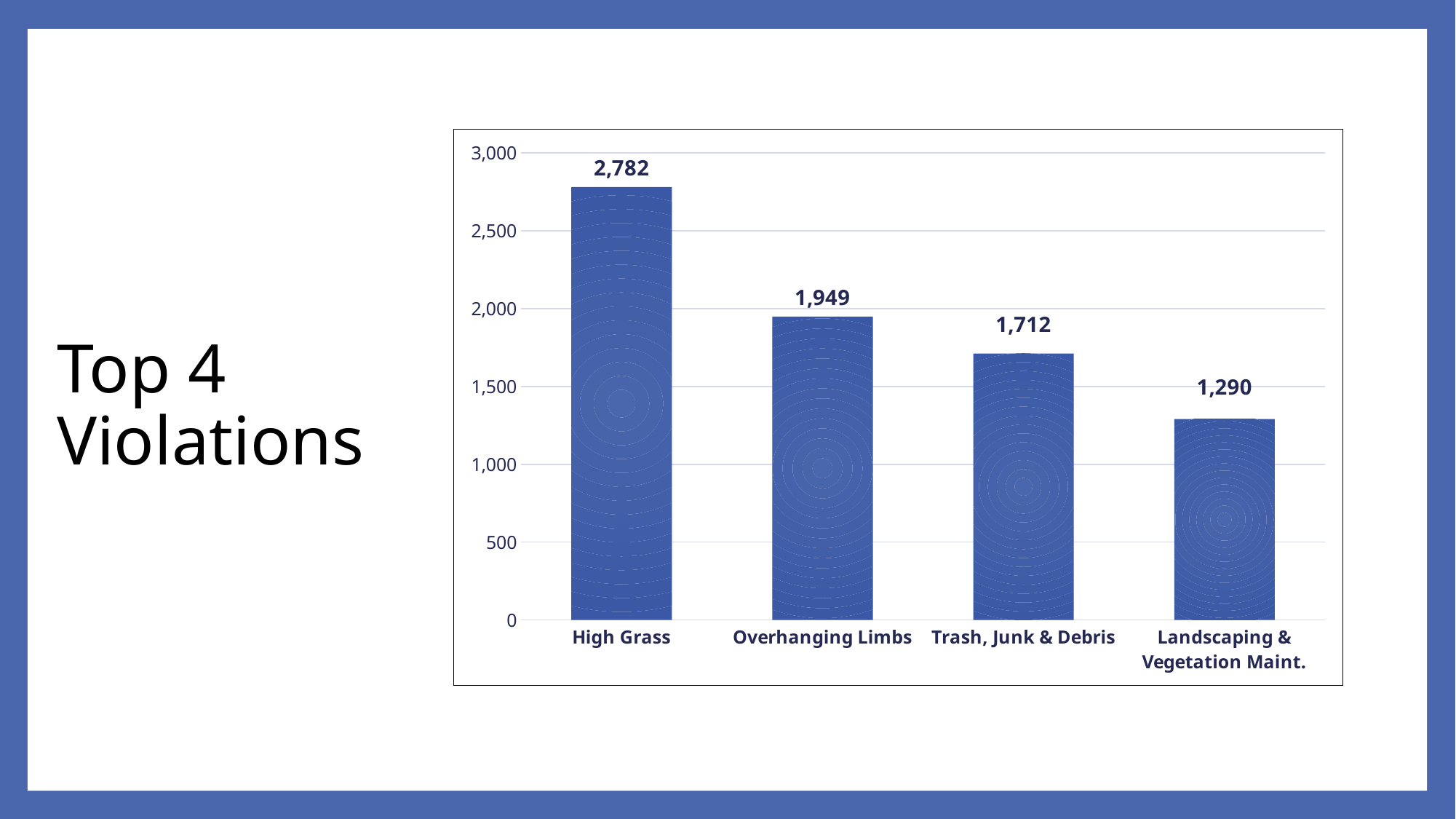
Which category has the lowest value? Landscaping & Vegetation Maint. Do the values rise or fall from left to right across the categories? Fall Which is larger, the value for Overhanging Limbs or the value for Trash, Junk & Debris? Overhanging Limbs What is the value for Overhanging Limbs? 1,949 What kind of chart is shown on the slide? Bar chart What is the value for Trash, Junk & Debris? 1,712 What is the difference between the values for Trash, Junk & Debris and Landscaping & Vegetation Maint.? 422 What is the value for Landscaping & Vegetation Maint.? 1,290 What is the value for High Grass? 2,782 What is the difference between the values for High Grass and Overhanging Limbs? 833 How many categories are shown in the chart? 4 Which category has the highest value? High Grass